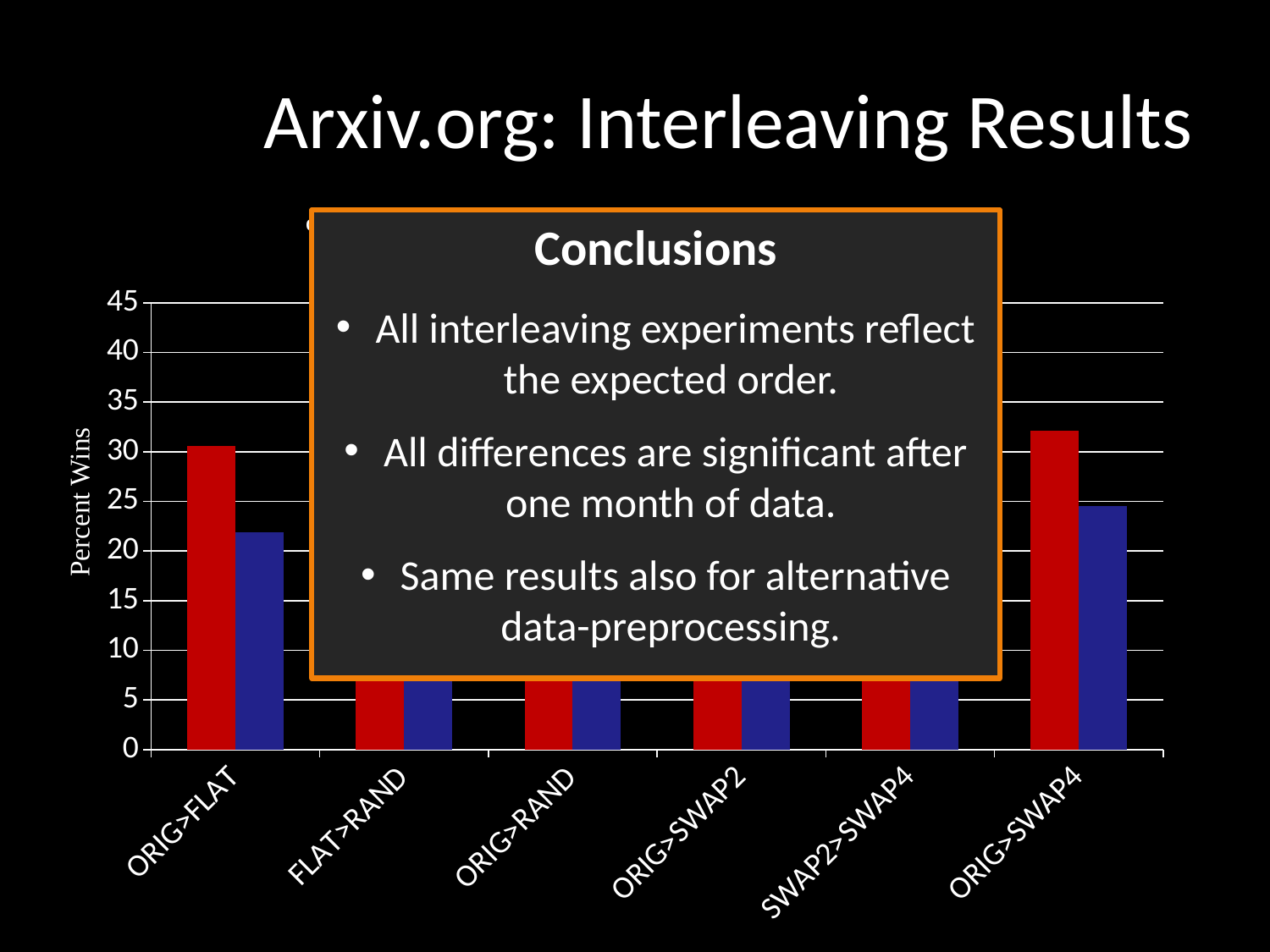
What is the highest tick value shown on the y axis of the chart? 45 What kind of chart is shown on the slide? bar chart Is the value of the red bar for ORIG>FLAT greater or less than 25? greater Which has the taller blue bar, ORIG>FLAT or ORIG>SWAP4? ORIG>SWAP4 Is the value of the blue bar for ORIG>SWAP4 greater or less than 30? less Is the value of the blue bar for ORIG>FLAT greater or less than 25? less What is the label of the y axis of the chart? Percent Wins For ORIG>FLAT, which bar is taller, the red bar or the blue bar? the red bar How many categories are shown on the x axis of the chart? 6 For ORIG>SWAP4, which bar is taller, the red bar or the blue bar? the red bar